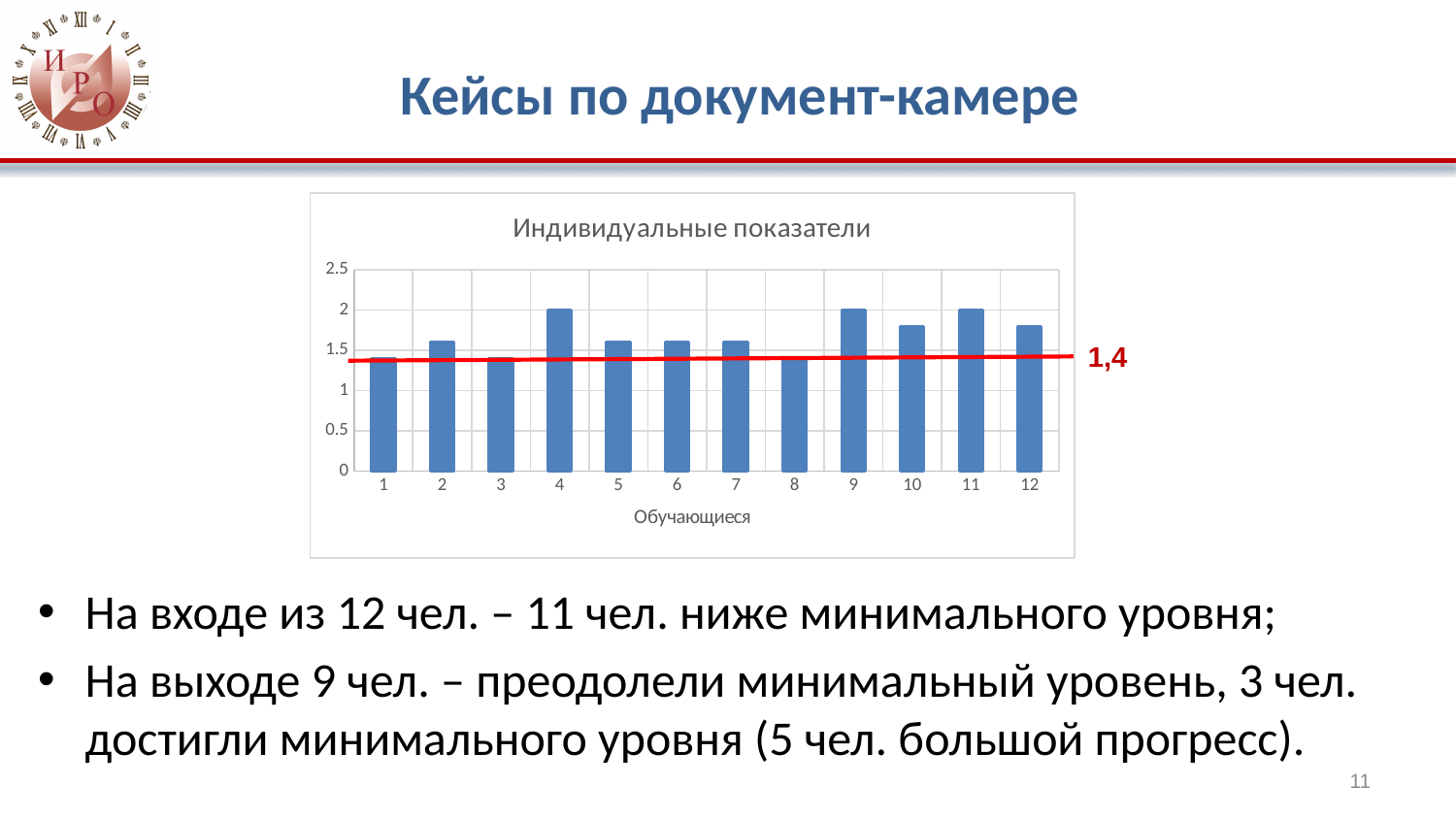
What value is labelled on the red horizontal line in the chart? 1,4 What kind of chart is shown on the slide? bar chart Which has the larger value, category 3 or category 9? 9 Is the value for category 2 greater or less than 1.5? greater Is the value for category 10 greater or less than 1.5? greater Which has the larger value, category 4 or category 1? 4 Is the value for category 8 greater or less than 1.5? less How many categories (обучающиеся) are plotted on the x axis of the chart? 12 Which has the larger value, category 10 or category 8? 10 What is the title of the chart? Индивидуальные показатели